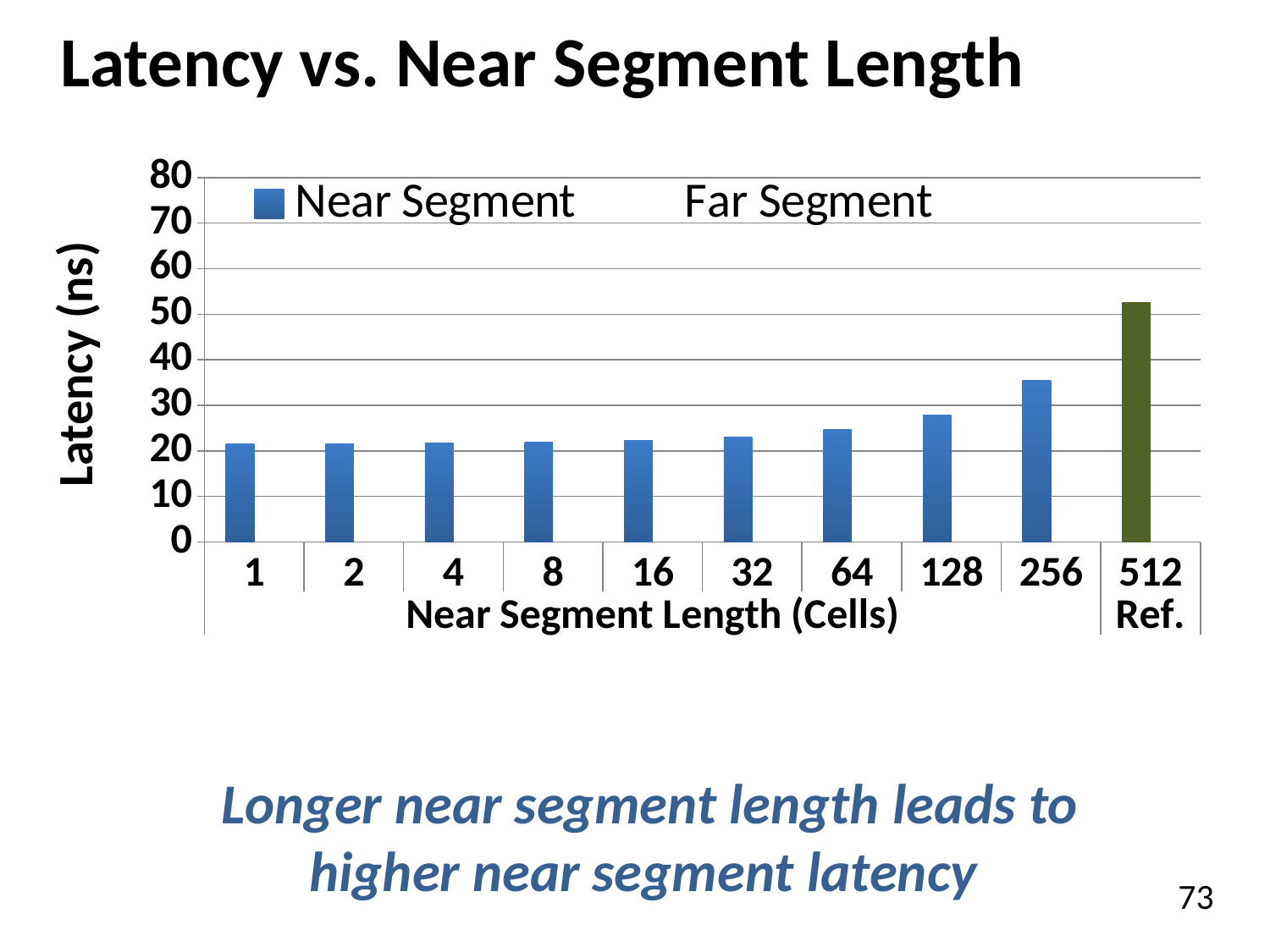
Is the latency for 512 Ref. greater or less than 40? greater Which has the higher latency, near segment length 128 or 256? 256 Is the latency for near segment length 128 greater or less than 30? less Is the latency for near segment length 64 greater or less than 30? less Do the latency values rise or fall as near segment length increases along the x axis? rise Which category has the highest latency? 512 Ref. How many series does the legend list? 2 What kind of chart is shown on the slide? bar chart What is the title of the y axis? Latency (ns) How many bars are plotted in the chart? 10